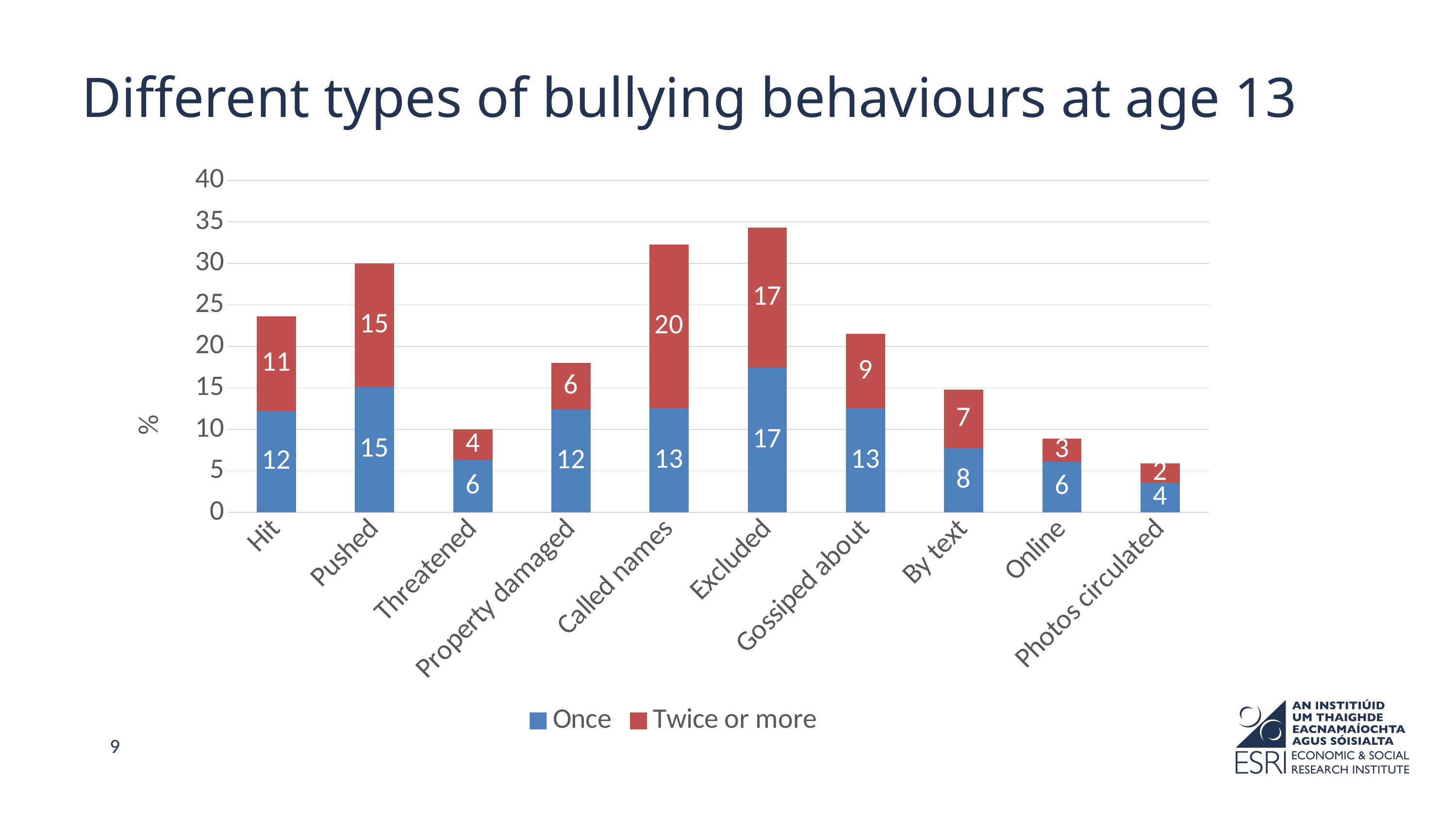
What is the total of the stacked bar for Pushed? 30 How many series does the legend list? 2 What is the difference between the 'Twice or more' values for Called names and Hit? 9 Which has the larger 'Once' value, Pushed or Hit? Pushed What is the 'Once' value for By text? 8 What kind of chart is shown on the slide? Stacked bar chart How many bullying behaviour categories are shown on the x axis? 10 Which category has the lowest 'Once' value? Photos circulated What is the 'Once' value for Excluded? 17 Is the total stacked value for Excluded greater or less than 30? greater Which category has the highest 'Twice or more' value? Called names What is the 'Twice or more' value for Called names? 20